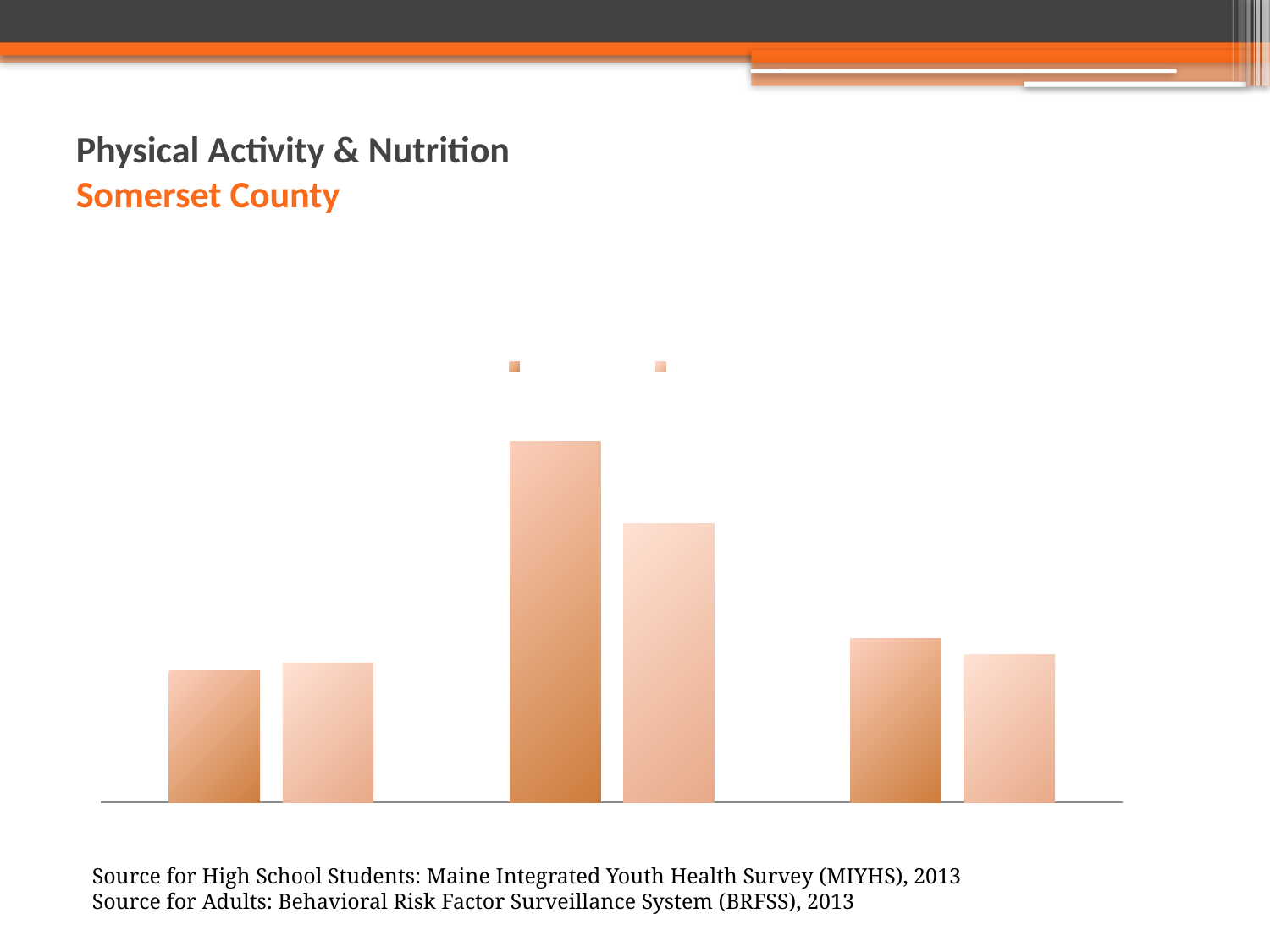
In the middle group, is the darker orange bar or the lighter orange bar taller? darker orange bar How many bars are plotted in the chart? 6 Does the chart display any data labels on the bars? No In the left group, is the darker orange bar or the lighter orange bar taller? lighter orange bar How many groups of bars does the chart show along the x axis? 3 Which group of bars is the shortest: the left, middle, or right group? left Which group of bars is the tallest: the left, middle, or right group? middle What kind of chart is shown on the slide? bar chart Are the bars in the chart vertical or horizontal? vertical How many series does the legend list? 2